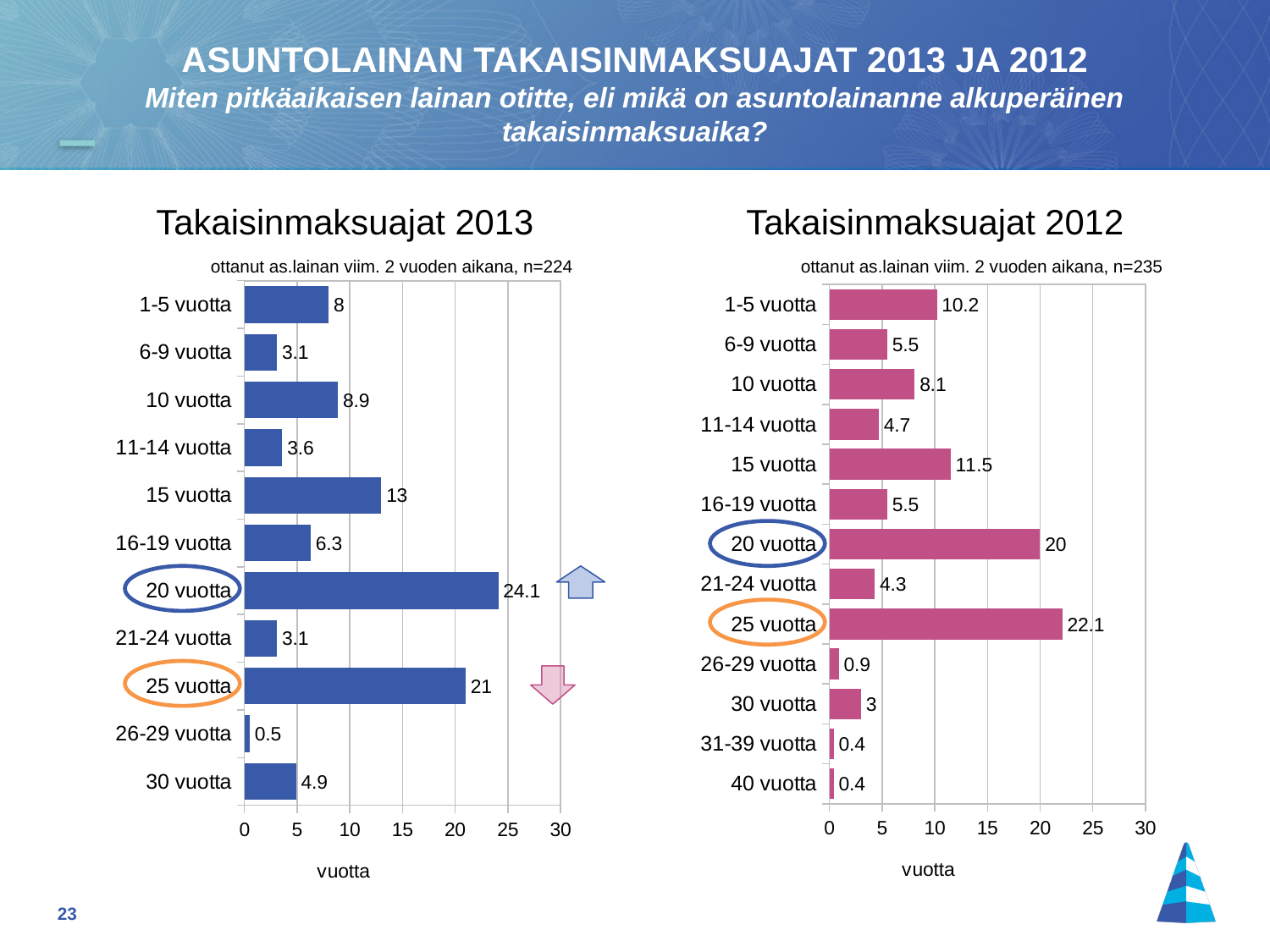
In the 'Takaisinmaksuajat 2012' chart, what is the value for 25 vuotta? 22.1 How many categories are shown in the 'Takaisinmaksuajat 2012' chart? 13 In the 'Takaisinmaksuajat 2012' chart, what is the difference between the values for 25 vuotta and 20 vuotta? 2.1 In the 'Takaisinmaksuajat 2013' chart, what is the difference between the values for 20 vuotta and 25 vuotta? 3.1 What type of chart is the 'Takaisinmaksuajat 2012' chart? Bar chart How many categories are shown in the 'Takaisinmaksuajat 2013' chart? 11 In the 'Takaisinmaksuajat 2013' chart, which category has the highest value? 20 vuotta What is the sample size (n) given in the subtitle of the 'Takaisinmaksuajat 2013' chart? n=224 In the 'Takaisinmaksuajat 2013' chart, which category has the lowest value? 26-29 vuotta In the 'Takaisinmaksuajat 2013' chart, what is the value for 20 vuotta? 24.1 In the 'Takaisinmaksuajat 2012' chart, which category has the highest value? 25 vuotta In the 'Takaisinmaksuajat 2012' chart, which is larger, the value for 15 vuotta or the value for 1-5 vuotta? 15 vuotta